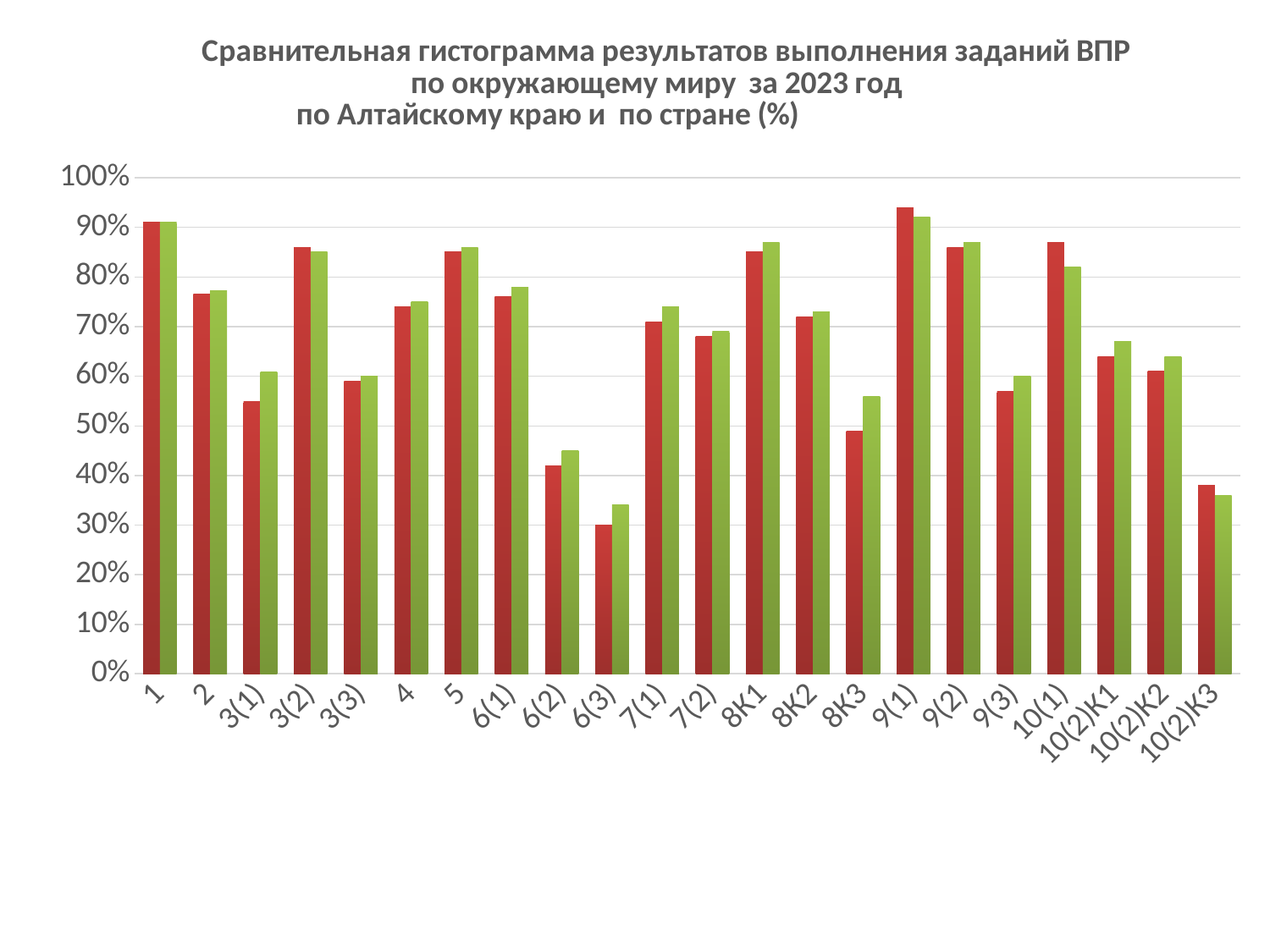
For category 8К3, which bar is taller, the red one or the green one? green Which category has the shortest bar in the chart? 6(3) Is the red bar for 10(2)К3 greater or less than 40%? less Which year do the results in the chart title refer to? 2023 How many categories are shown along the x axis of the chart? 22 Is the green bar for 6(3) greater or less than 40%? less What kind of chart is shown on the slide? bar chart For category 10(1), which bar is taller, the red one or the green one? red Is the green bar for 3(1) greater or less than 70%? less Which category has the tallest bar in the chart? 9(1)